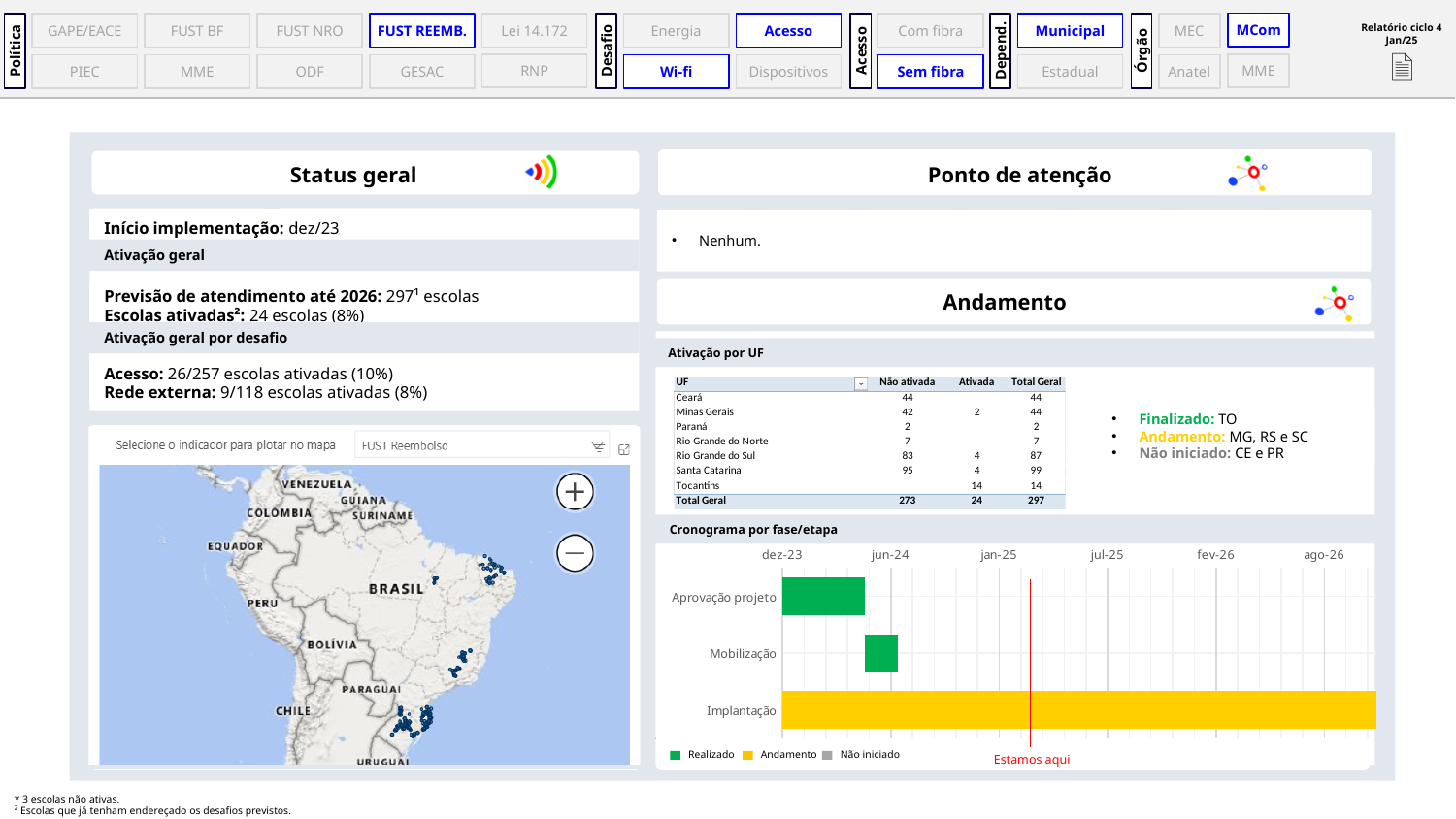
In the 'Cronograma por fase/etapa' chart, which phase is shown with the 'Andamento' (yellow) colour? Implantação What kind of chart is the 'Cronograma por fase/etapa' chart? bar chart In the 'Cronograma por fase/etapa' chart, which phase has the shortest bar? Mobilização In the 'Cronograma por fase/etapa' chart, which phases are shown as 'Realizado'? Aprovação projeto and Mobilização In the 'Cronograma por fase/etapa' chart, is the bar for Aprovação projeto longer or shorter than the bar for Mobilização? longer In the 'Cronograma por fase/etapa' chart, which phase has the longest bar? Implantação How many entries does the legend of the 'Cronograma por fase/etapa' chart list? 3 What are the legend entries of the 'Cronograma por fase/etapa' chart? Realizado, Andamento, Não iniciado What is the last label on the x axis of the 'Cronograma por fase/etapa' chart? ago-26 How many phases are listed on the y axis of the 'Cronograma por fase/etapa' chart? 3 In the 'Cronograma por fase/etapa' chart, at which x-axis label is the 'Estamos aqui' marker placed? jan-25